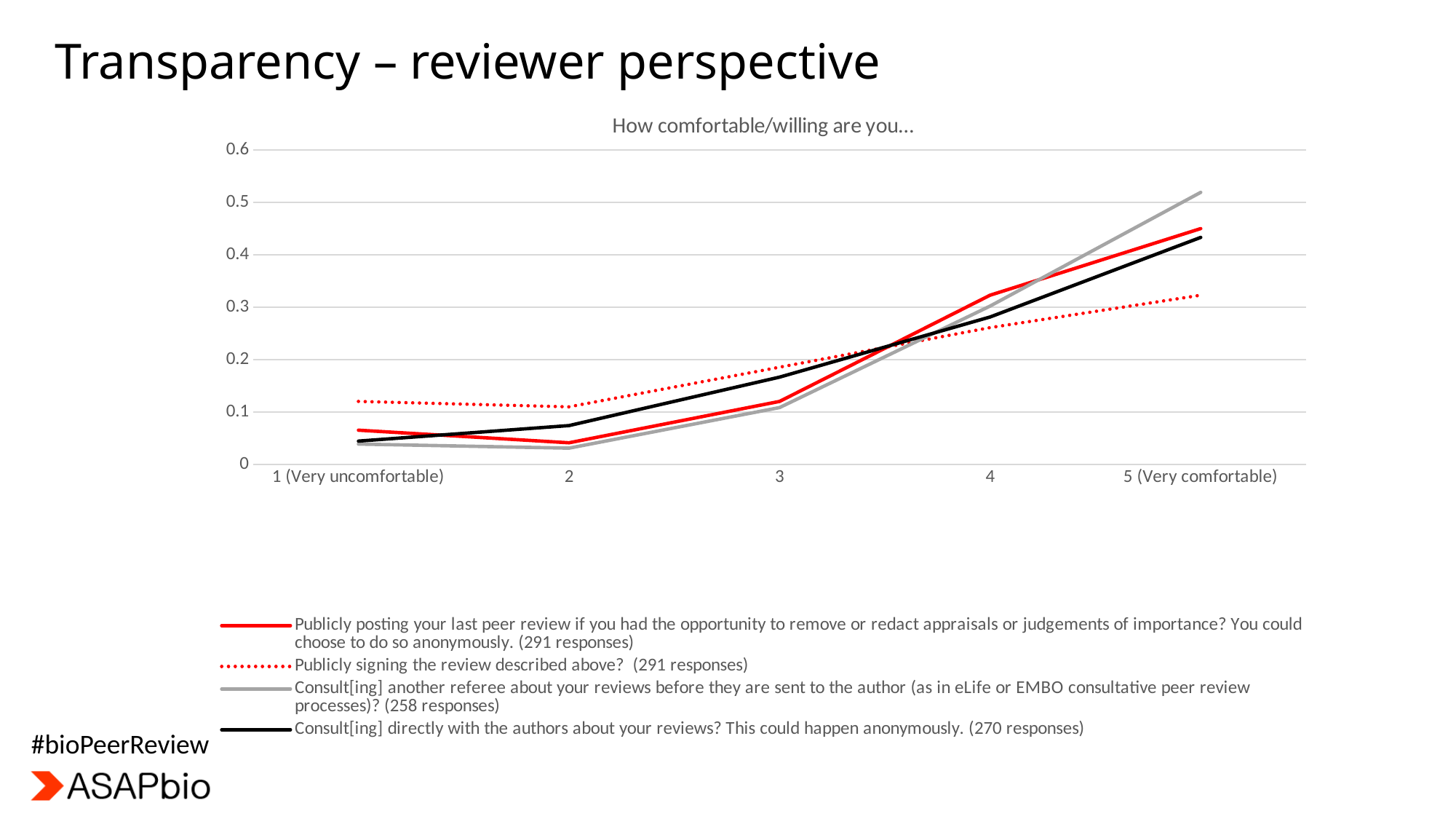
Which series has the highest value at 5 (Very comfortable)? Consult[ing] another referee about your reviews before they are sent to the author (258 responses) How many categories are shown along the x axis? 5 Is the value for 'Publicly signing the review described above?' at 5 (Very comfortable) greater or less than 0.4? less At 1 (Very uncomfortable), which is larger: the value for 'Publicly signing the review described above?' or the value for 'Publicly posting your last peer review'? Publicly signing the review described above? Does the line for 'Consult[ing] another referee about your reviews' rise or fall from 2 to 5 (Very comfortable)? rise What is the title of the chart? How comfortable/willing are you… Which series has the highest value at 1 (Very uncomfortable)? Publicly signing the review described above? (291 responses) How many series does the legend list? 4 Is the value for 'Consult[ing] another referee about your reviews before they are sent to the author' at 5 (Very comfortable) greater or less than 0.5? greater What kind of chart is shown on the slide? Line chart Is the value for 'Consult[ing] directly with the authors about your reviews?' at 3 greater or less than 0.2? less Which series has the lowest value at 5 (Very comfortable)? Publicly signing the review described above? (291 responses)